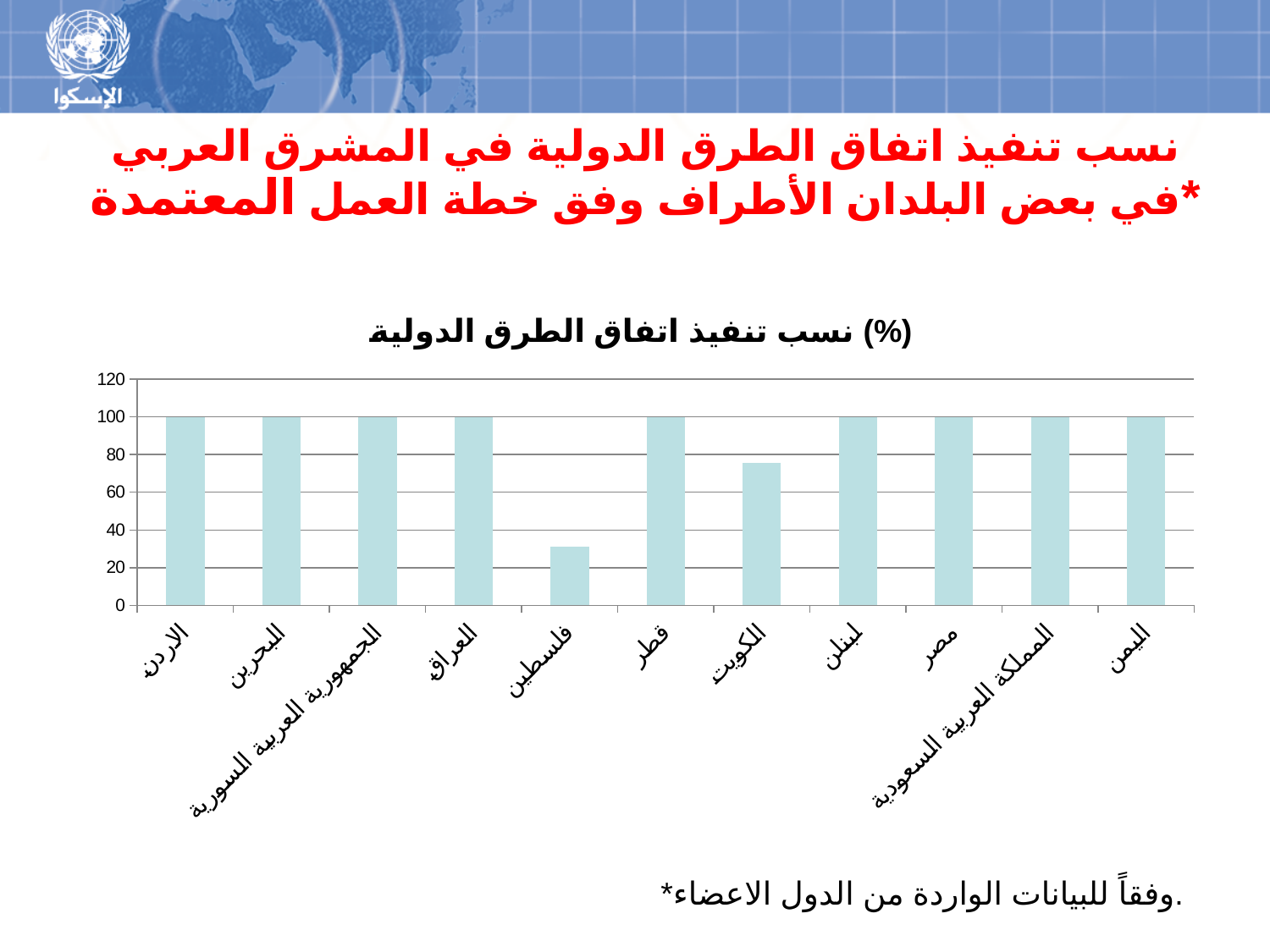
What is the title of the chart? نسب تنفيذ اتفاق الطرق الدولية (%) Which country has the lowest value in the chart? فلسطين How many countries are shown on the x axis of the chart? 11 What is the value for الأردن in the chart? 100 Is the value for الكويت greater or less than 80? less What is the value for قطر in the chart? 100 How many countries in the chart have a value of 100? 9 What type of chart is shown on the slide? bar chart Is the value for فلسطين greater or less than 40? less Is the value for الكويت greater or less than 60? greater Which has a larger value, الكويت or فلسطين? الكويت What is the value for اليمن in the chart? 100